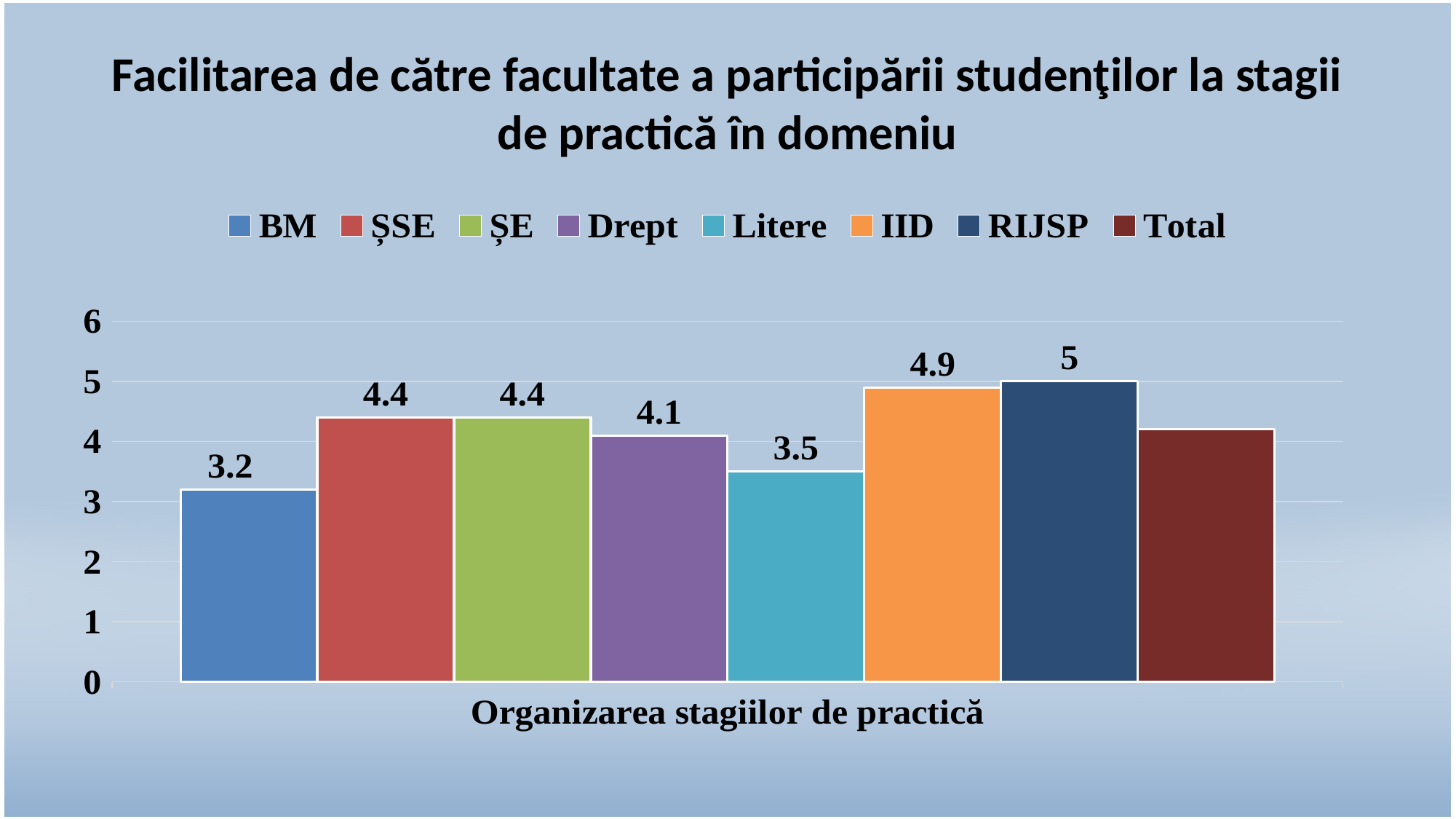
Which series has the lowest value? BM Which is larger, the value for IID or the value for Drept? IID What is the difference between the values for IID and Litere? 1.4 What is the value for BM? 3.2 What is the value for Litere? 3.5 Which series has the highest value? RIJSP What kind of chart is shown on the slide? bar chart How many series does the legend list? 8 What is the value for IID? 4.9 Is the value for Total greater or less than 4? greater What is the value for Drept? 4.1 What is the difference between the values for RIJSP and BM? 1.8